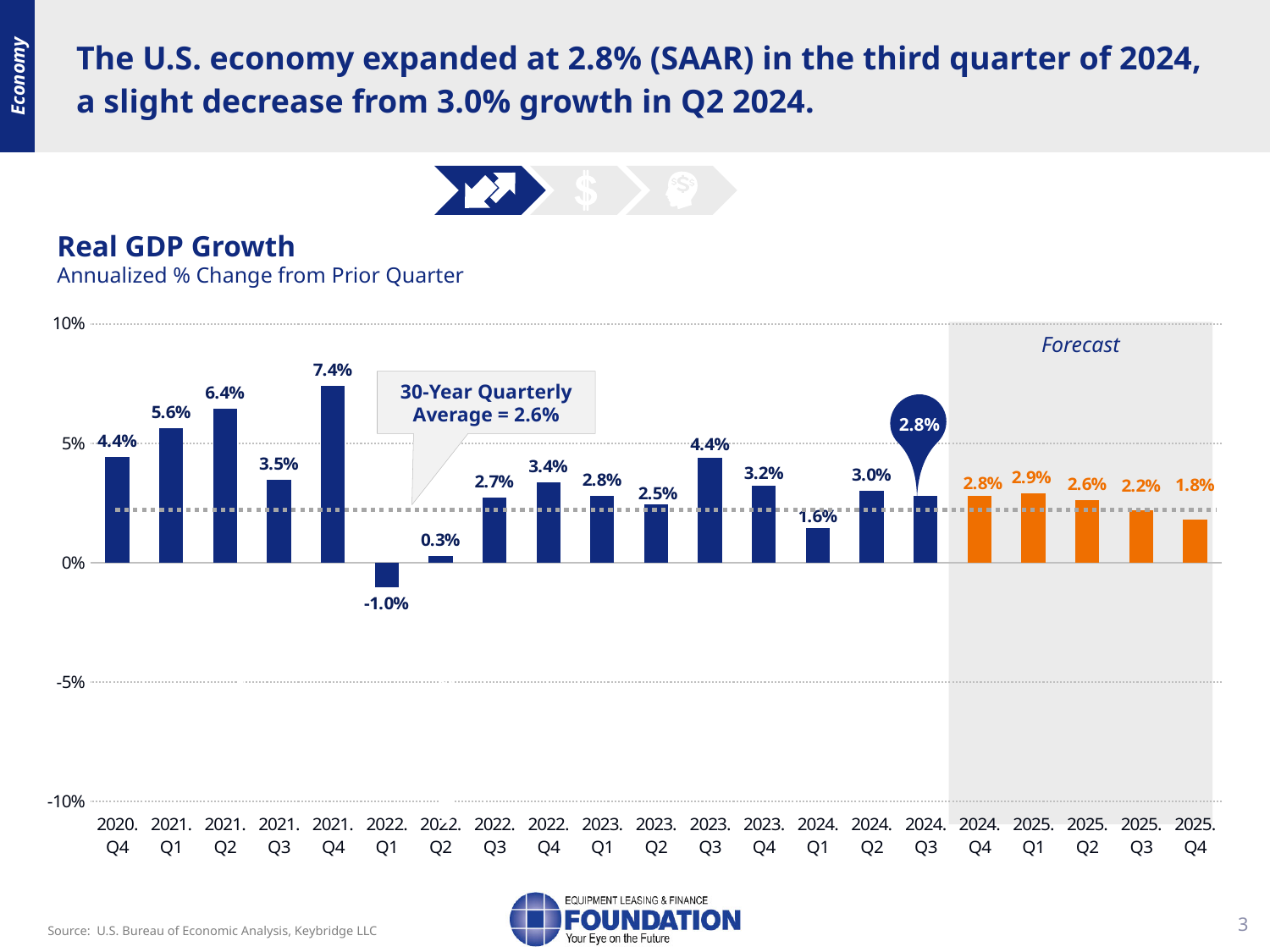
What is the forecast Real GDP Growth value for 2025 Q4? 1.8% What is the difference between the Real GDP Growth values for 2021 Q2 and 2021 Q3? 2.9% What is the Real GDP Growth value for 2024 Q1? 1.6% Which is larger, the Real GDP Growth value for 2023 Q3 or for 2023 Q4? 2023 Q3 What 30-year quarterly average is noted in the callout on the chart? 2.6% Which quarter has the highest Real GDP Growth value on the chart? 2021 Q4 What is the Real GDP Growth value for 2021 Q4? 7.4% What kind of chart is used to show Real GDP Growth? Bar chart What is the difference between the Real GDP Growth values for 2024 Q2 and 2024 Q3? 0.2% Do the forecast values from 2025 Q1 to 2025 Q4 rise or fall? Fall How many quarters are plotted on the Real GDP Growth chart? 21 Which quarter has the lowest Real GDP Growth value on the chart? 2022 Q1